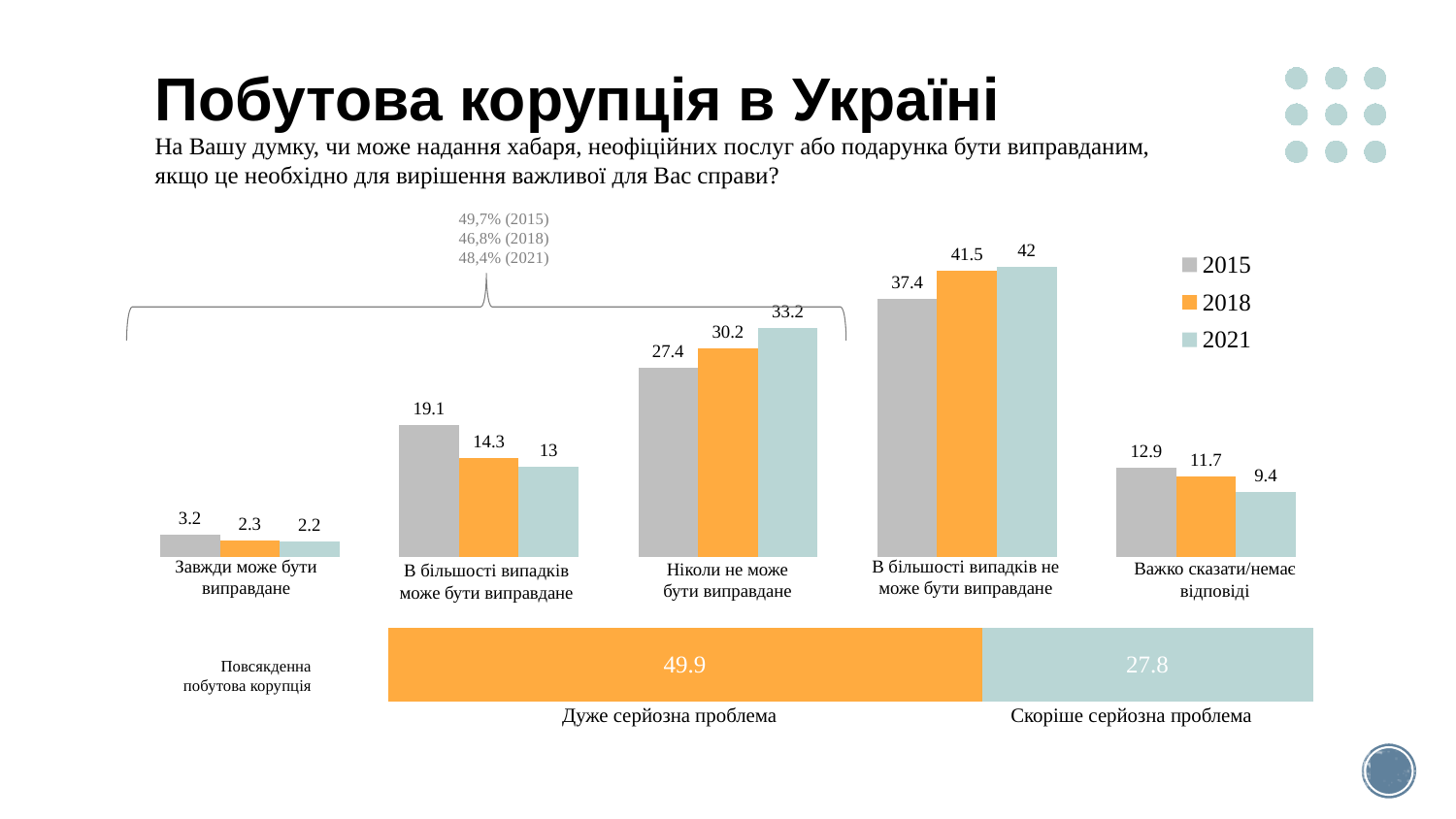
In the upper grouped bar chart, which category has the highest 2021 value? В більшості випадків не може бути виправдане In the upper grouped bar chart, which category has the lowest 2015 value? Завжди може бути виправдане How many categories are shown in the upper grouped bar chart? 5 In the upper grouped bar chart, do the values for "В більшості випадків може бути виправдане" rise or fall from 2015 to 2021? fall In the upper grouped bar chart, which is larger for "Важко сказати/немає відповіді": the 2015 value or the 2021 value? 2015 In the upper grouped bar chart, what is the 2021 value for "Ніколи не може бути виправдане"? 33.2 How many series does the legend of the upper grouped bar chart list? 3 In the upper grouped bar chart, what is the 2015 value for "В більшості випадків може бути виправдане"? 19.1 What is the total of the lower stacked bar for "Повсякденна побутова корупція"? 77.7 In the upper grouped bar chart, what is the 2018 value for "Важко сказати/немає відповіді"? 11.7 In the lower stacked bar for "Повсякденна побутова корупція", what is the value for "Дуже серйозна проблема"? 49.9 In the upper grouped bar chart, what is the difference between the 2021 and 2015 values for "Ніколи не може бути виправдане"? 5.8